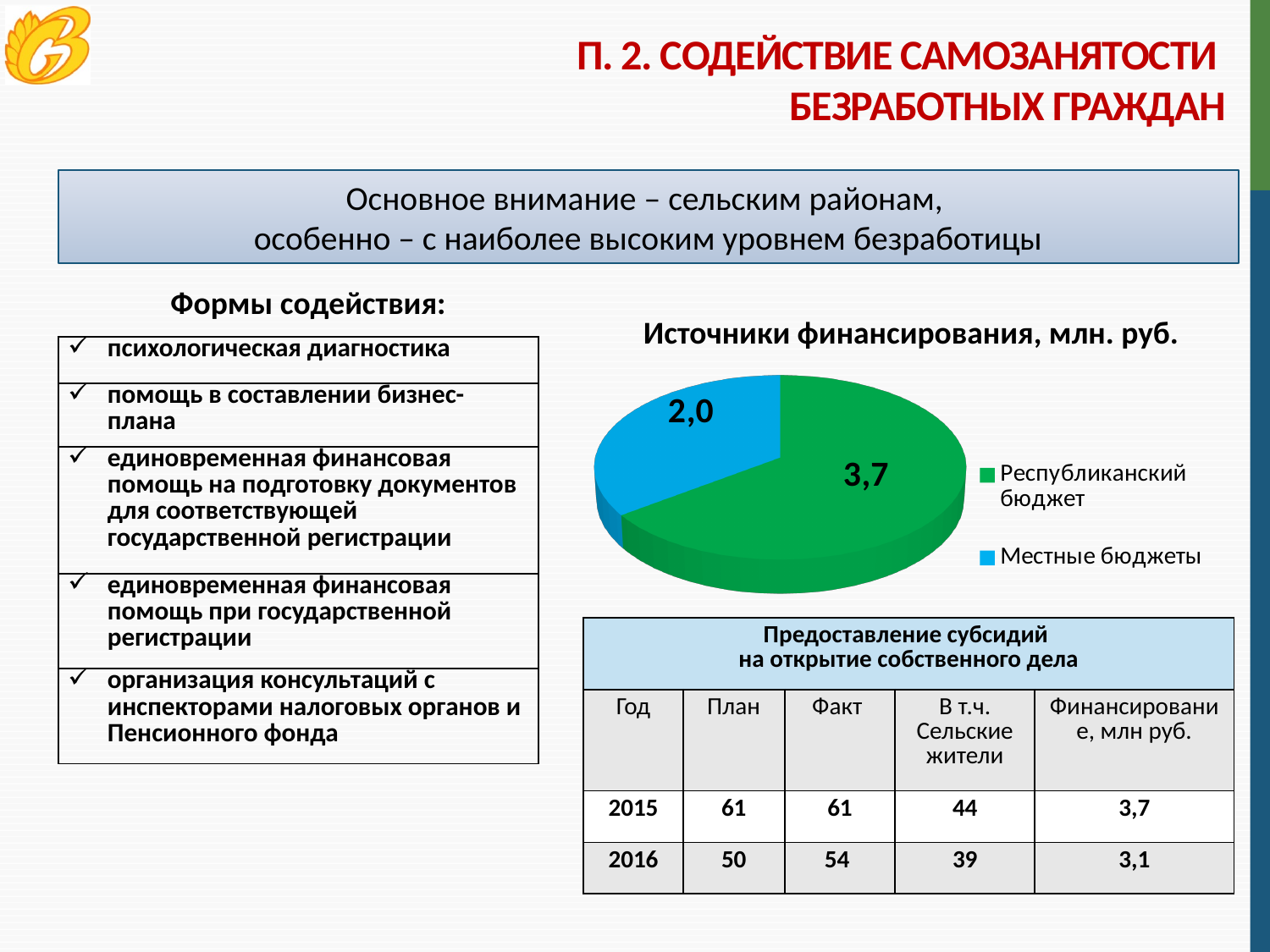
What kind of chart is shown under the title "Источники финансирования, млн. руб."? pie chart In the pie chart "Источники финансирования, млн. руб.", what is the total of the two slices? 5,7 In the pie chart "Источники финансирования, млн. руб.", what is the value for "Республиканский бюджет"? 3,7 What is the title of the pie chart on the slide? Источники финансирования, млн. руб. In the pie chart "Источники финансирования, млн. руб.", which is larger: "Республиканский бюджет" or "Местные бюджеты"? Республиканский бюджет In the pie chart "Источники финансирования, млн. руб.", which source has the smallest value? Местные бюджеты In the pie chart "Источники финансирования, млн. руб.", what is the value for "Местные бюджеты"? 2,0 In the pie chart "Источники финансирования, млн. руб.", what is the difference between the value for "Республиканский бюджет" and the value for "Местные бюджеты"? 1,7 How many entries does the legend of the pie chart "Источники финансирования, млн. руб." list? 2 In the pie chart "Источники финансирования, млн. руб.", what colour is the slice for "Местные бюджеты"? blue In the pie chart "Источники финансирования, млн. руб.", which source has the largest value? Республиканский бюджет How many slices does the pie chart "Источники финансирования, млн. руб." have? 2